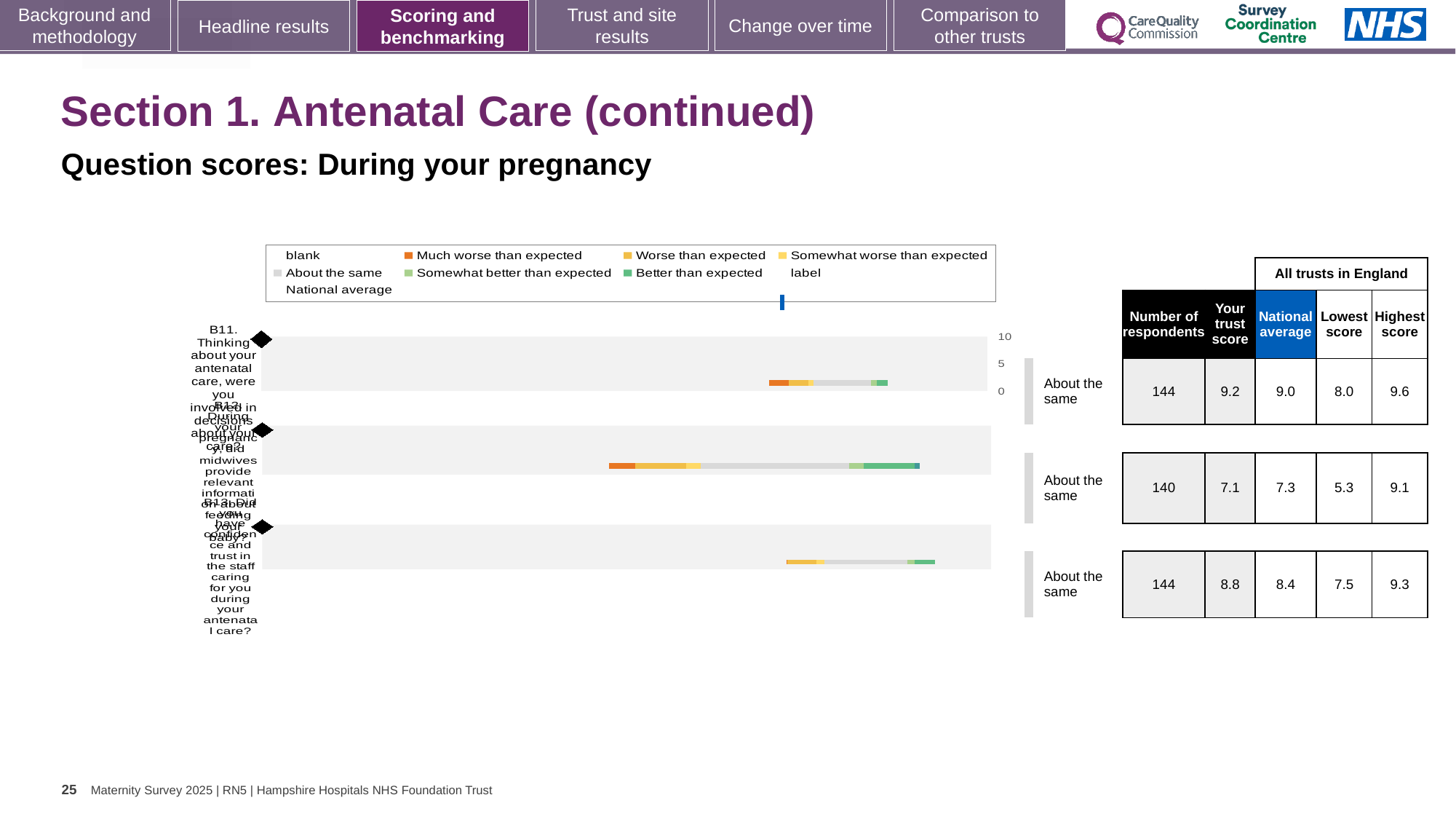
Which question has the highest 'Your trust score'? B11 How many questions (categories) are plotted in the chart? 3 What is the difference between the trust score and the national average for question B13? 0.4 What is the highest score among all trusts in England for question B13? 9.3 What is the national average for question B12 (midwives provide relevant information about feeding your baby)? 7.3 How many respondents answered question B12? 140 What benchmark category is shown next to the bar for question B12? About the same What is the lowest score among all trusts in England for question B12? 5.3 What is the 'Your trust score' for question B11 (involved in decisions about your care)? 9.2 What kind of chart is used to show the question scores for B11, B12 and B13? bar chart Which question has the lowest 'Your trust score'? B12 For question B11, which is larger: the trust score or the national average? the trust score (9.2)